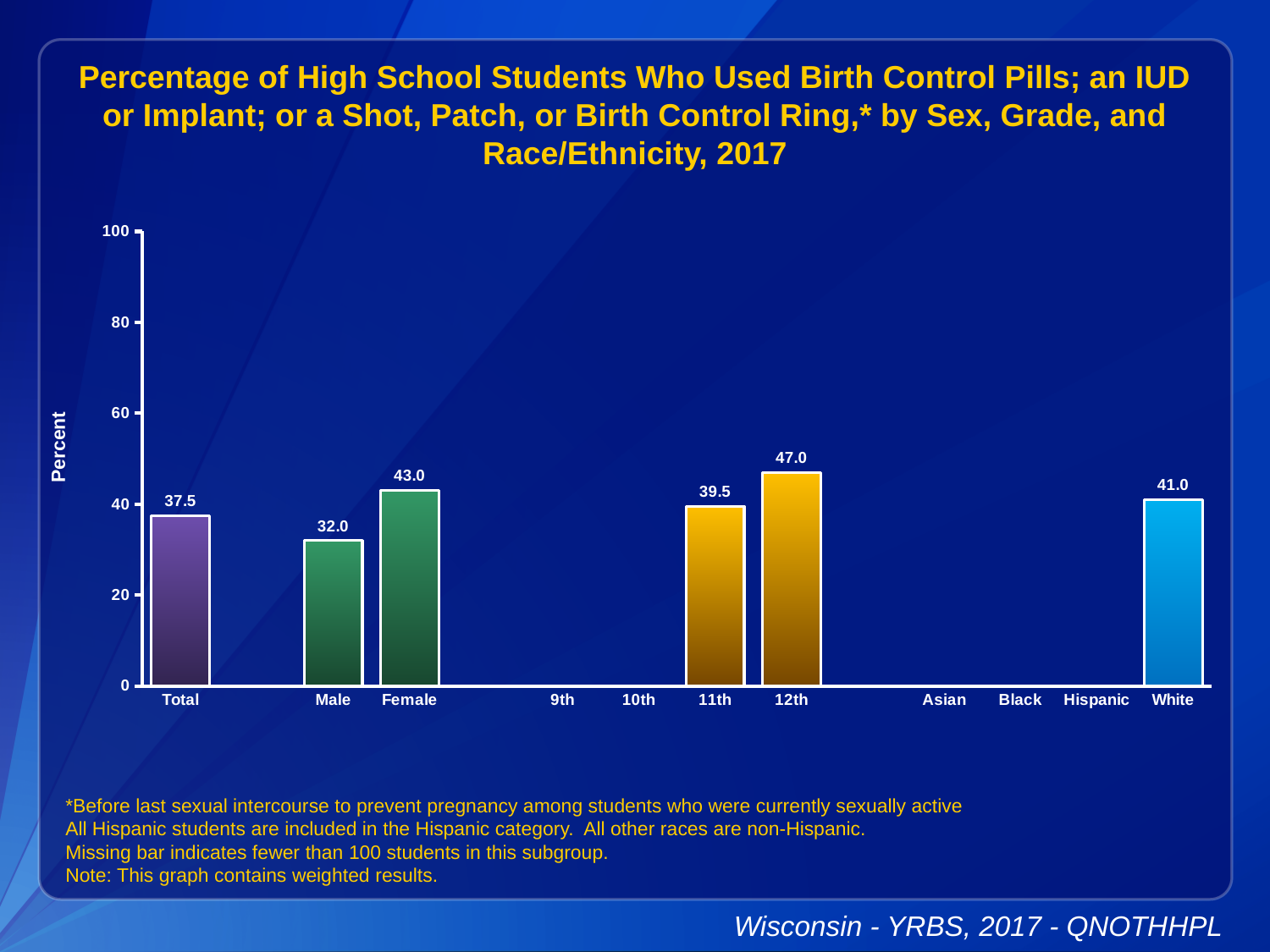
Which category has the highest value? 12th Which category with a bar has the lowest value? Male What is the value for Female? 43.0 Is the value for 12th grade greater or less than 40? greater What kind of chart is shown? bar chart What is the label on the y axis? Percent What is the value for White? 41.0 What is the difference between the Female and Male values? 11.0 What is the value for Total? 37.5 Which is larger, the value for 11th grade or the value for White? White What is the value for 12th grade? 47.0 How many categories have a bar plotted? 6